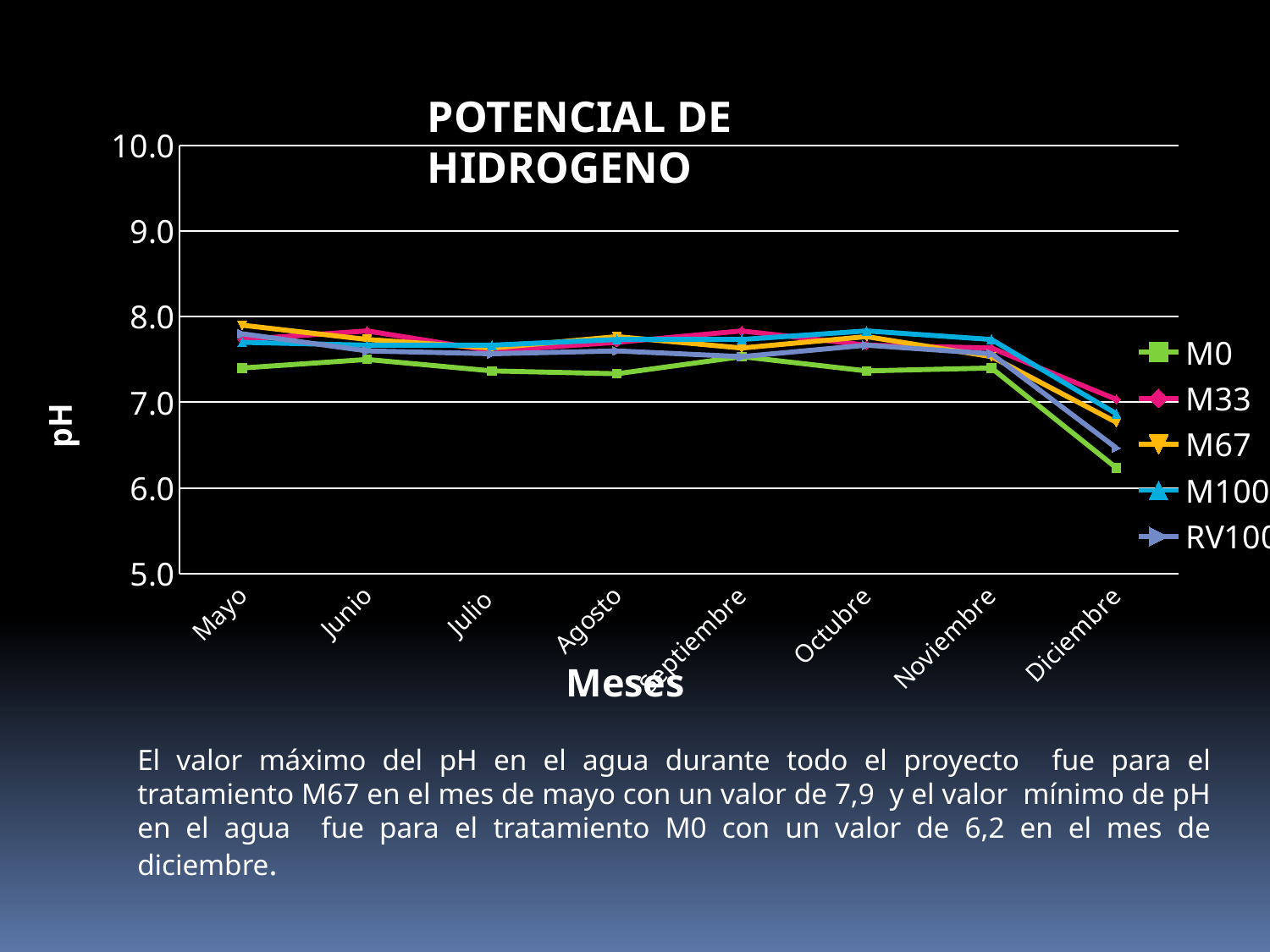
What is the pH value for M0 in Diciembre? 6,2 Which treatment has the highest pH value in Mayo? M67 Is the value for M0 in Diciembre greater or less than 7.0? less How many months are shown on the x axis? 8 What is the label of the vertical axis? pH How many series does the legend list? 5 Which treatment has the lowest pH value in Diciembre? M0 What is the pH value for M67 in Mayo? 7,9 Is the value for M0 in Mayo greater or less than 7.0? greater Do the pH values for M0 rise or fall from Noviembre to Diciembre? fall What is the title of the chart? POTENCIAL DE HIDROGENO What kind of chart is shown on the slide? line chart